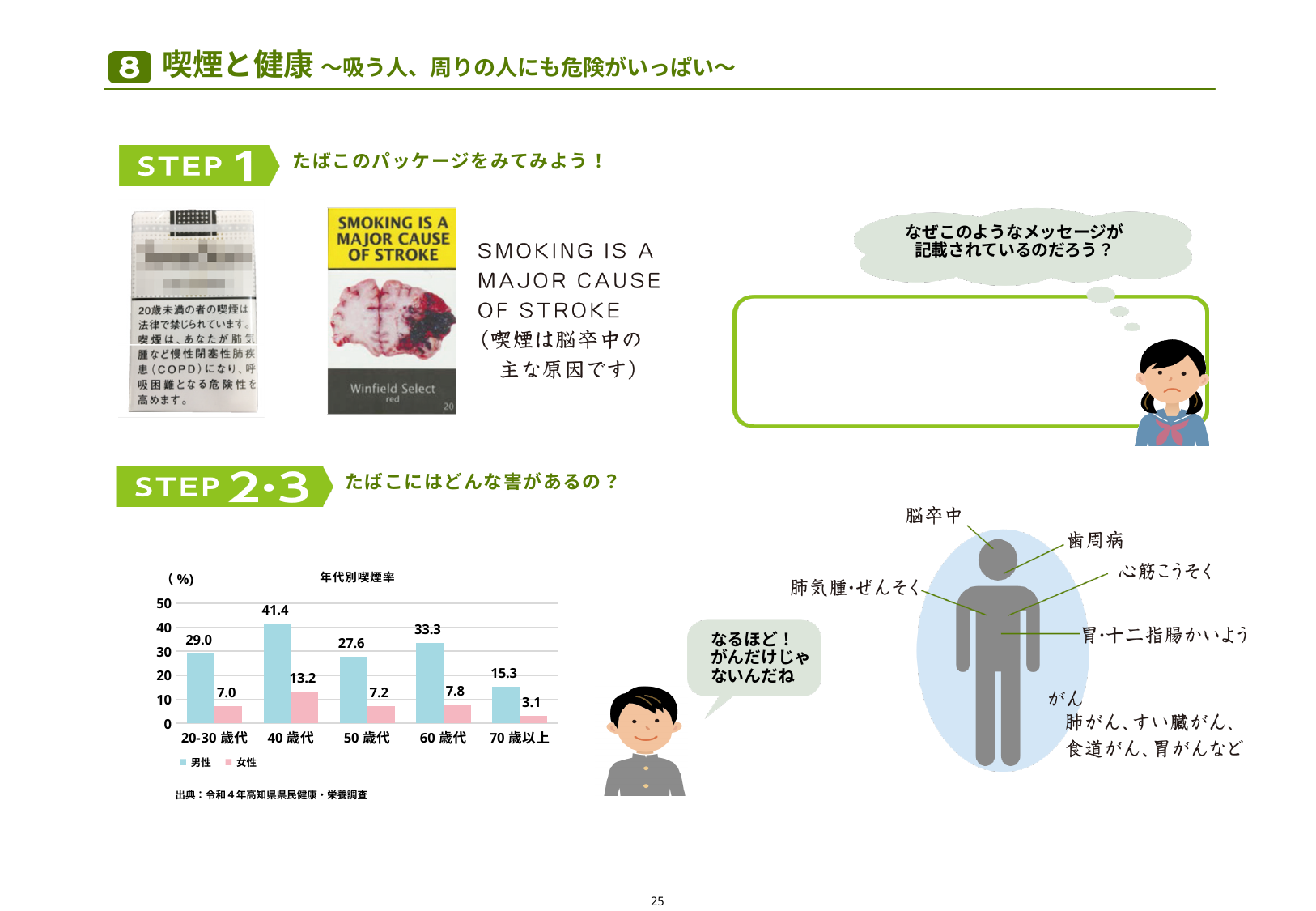
In the 年代別喫煙率 chart, which age group has the highest smoking rate for 男性? 40歳代 How many age groups are shown on the x axis of the 年代別喫煙率 chart? 5 In the 年代別喫煙率 chart, which age group has the lowest smoking rate for 女性? 70歳以上 In the 年代別喫煙率 chart, what is the difference between the 男性 and 女性 smoking rates in the 40歳代 group? 28.2 In the 年代別喫煙率 chart, what is the smoking rate for 男性 in the 60歳代 group? 33.3 What type of chart is shown under STEP 2・3 (年代別喫煙率)? bar chart In the 年代別喫煙率 chart, which colour represents 女性? pink How many series does the legend of the 年代別喫煙率 chart list? 2 In the 年代別喫煙率 chart, what is the smoking rate for 男性 in the 40歳代 group? 41.4 In the 年代別喫煙率 chart, what is the smoking rate for 女性 in the 70歳以上 group? 3.1 In the 年代別喫煙率 chart, which is larger: the 男性 rate for 20-30歳代 or the 男性 rate for 50歳代? 20-30歳代 In the 年代別喫煙率 chart, is the 男性 value for 60歳代 greater or less than 30? greater